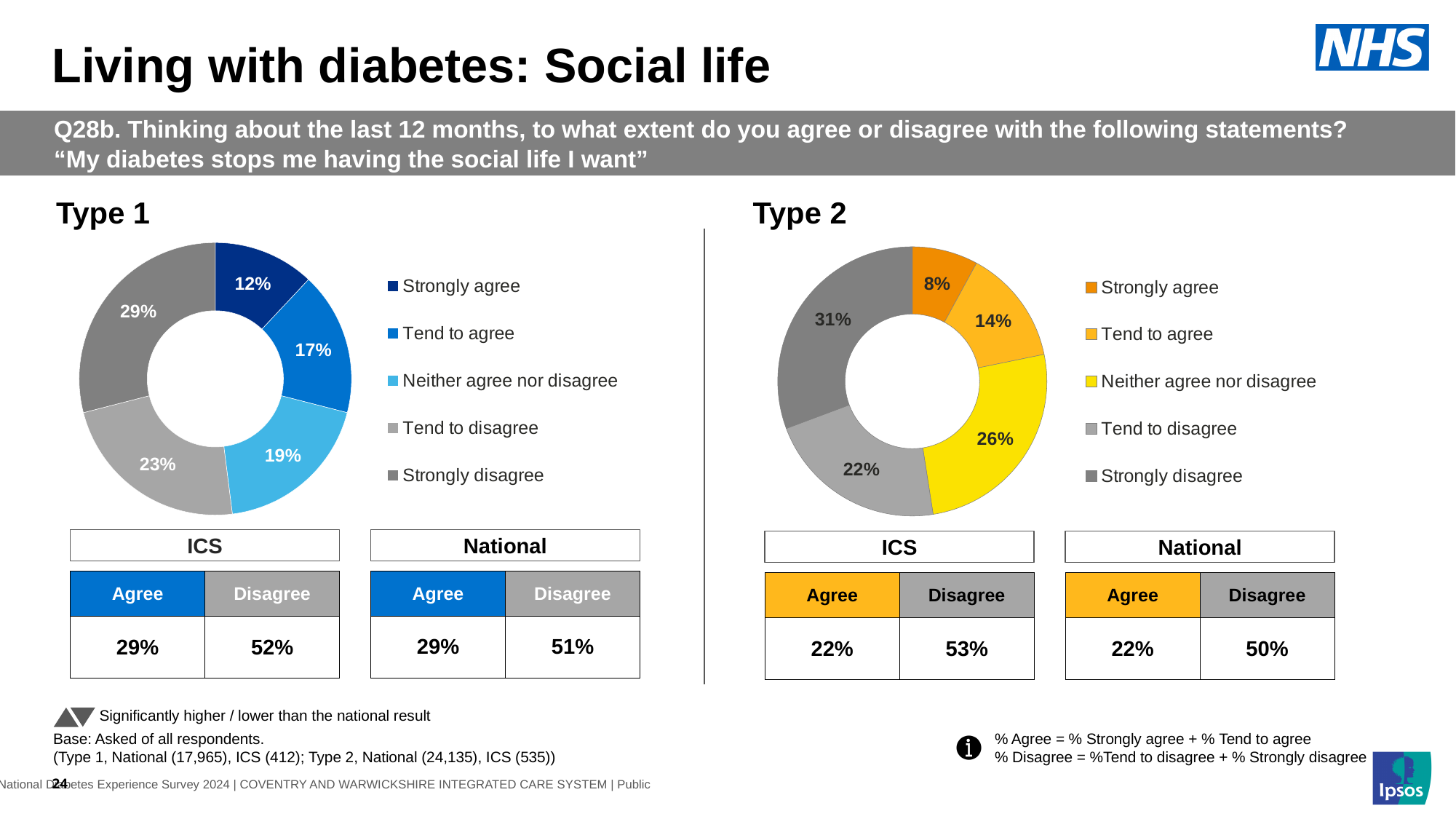
In the Type 1 chart, what percentage of respondents said 'Strongly agree'? 12% How many entries does the legend of the Type 2 chart list? 5 In the Type 2 chart, which response category has the smallest share? Strongly agree What kind of chart is used for Type 1? Doughnut chart In the Type 2 chart, what colour represents 'Strongly agree'? Orange In the Type 1 chart, which response category has the largest share? Strongly disagree How many response categories does the Type 1 chart show? 5 In the Type 2 chart, what percentage of respondents said 'Neither agree nor disagree'? 26% In the Type 2 chart, which is larger: 'Tend to agree' or 'Tend to disagree'? Tend to disagree In the Type 2 chart, what is the combined share of 'Strongly agree' and 'Tend to agree'? 22% In the Type 1 chart, what share of the doughnut is 'Neither agree nor disagree'? 19% In the Type 1 chart, what is the difference between the 'Tend to disagree' and 'Tend to agree' shares? 6 percentage points